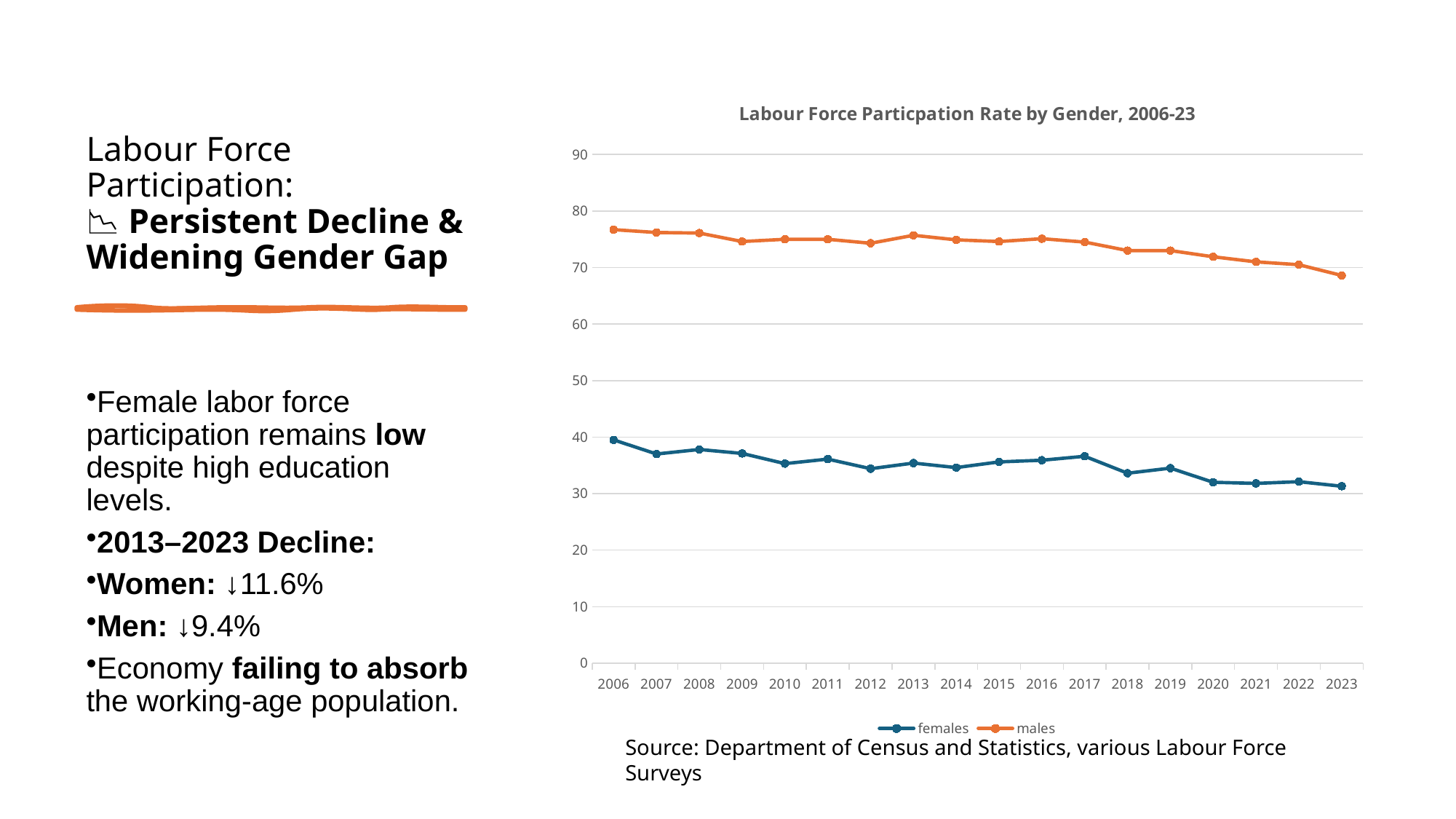
How many years are plotted along the x axis? 18 Does the males series rise or fall overall from 2006 to 2023? fall Is the value for females in 2023 greater or less than 30? greater Which two series are listed in the chart legend? females and males How many series does the legend list? 2 What is the title of the chart? Labour Force Particpation Rate by Gender, 2006-23 In which year is the males series at its lowest? 2023 In 2023, which series has the higher value, females or males? males Does the females series rise or fall overall from 2006 to 2023? fall What kind of chart is shown on the slide? line chart Is the value for males in 2006 greater or less than 70? greater Is the value for males in 2023 greater or less than 70? less